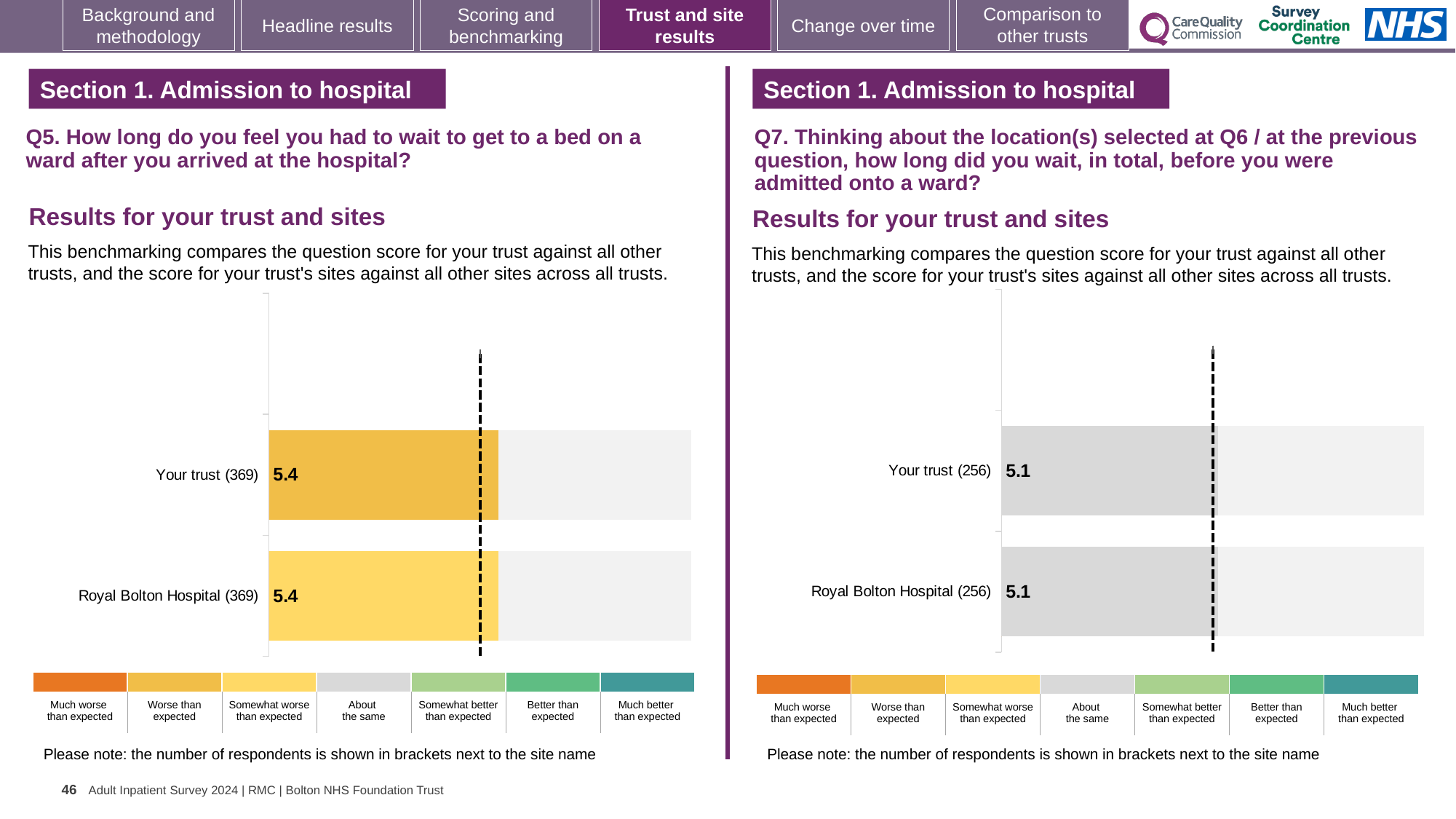
How many bars are plotted on the Q7 chart (right)? 2 On the Q7 chart (right), what is the score for Royal Bolton Hospital? 5.1 On the Q7 chart (right), what is the difference between the score for Your trust and the score for Royal Bolton Hospital? 0 On the Q7 chart (right), how many respondents are shown in brackets next to Royal Bolton Hospital? 256 On the Q5 chart (left), how many respondents are shown in brackets next to Your trust? 369 What kind of chart is the Q5 chart (left)? Bar chart On the Q7 chart (right), what is the score for Your trust? 5.1 Is the score for Your trust on the Q5 chart (left) larger or smaller than the score for Your trust on the Q7 chart (right)? Larger On the Q5 chart (left), what is the score for Royal Bolton Hospital? 5.4 How many bars are plotted on the Q5 chart (left)? 2 On the Q5 chart (left), what is the difference between the score for Your trust and the score for Royal Bolton Hospital? 0 On the Q5 chart (left), what is the score for Your trust? 5.4